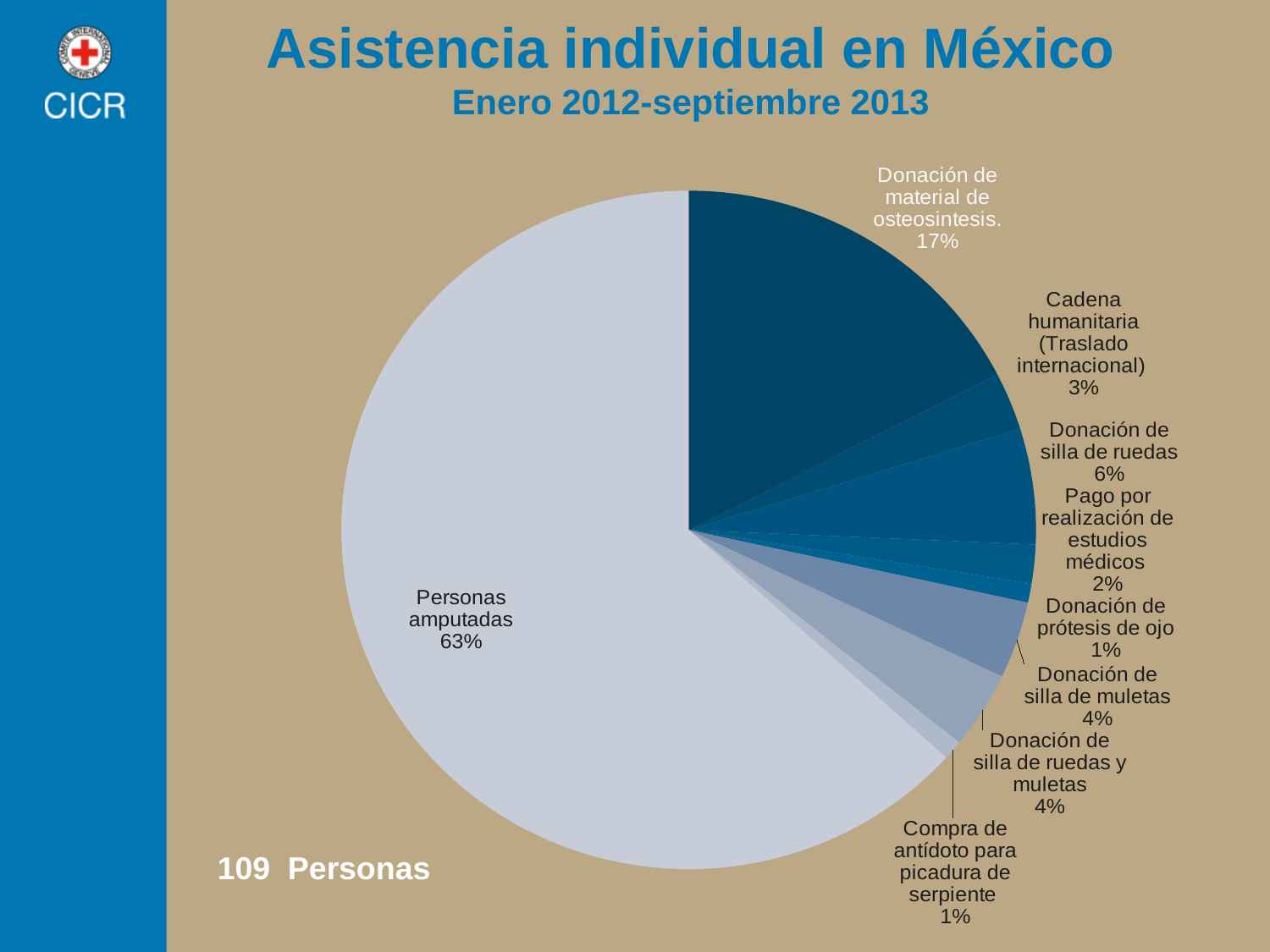
What is the difference in percentage points between 'Personas amputadas' and 'Donación de material de osteosintesis'? 46 Which is larger: 'Donación de silla de ruedas' or 'Cadena humanitaria (Traslado internacional)'? Donación de silla de ruedas What type of chart is shown on the slide? Pie chart What is the title of the slide containing the chart? Asistencia individual en México How many people does the text at the bottom left of the chart say the data covers? 109 Personas What share of the pie is labelled 'Personas amputadas'? 63% Which category has the largest slice of the pie? Personas amputadas What percentage is shown for 'Cadena humanitaria (Traslado internacional)'? 3% What percentage is shown for 'Donación de material de osteosintesis'? 17% What percentage is shown for 'Donación de silla de ruedas'? 6% How many slices does the pie chart have? 9 What percentage is shown for 'Pago por realización de estudios médicos'? 2%